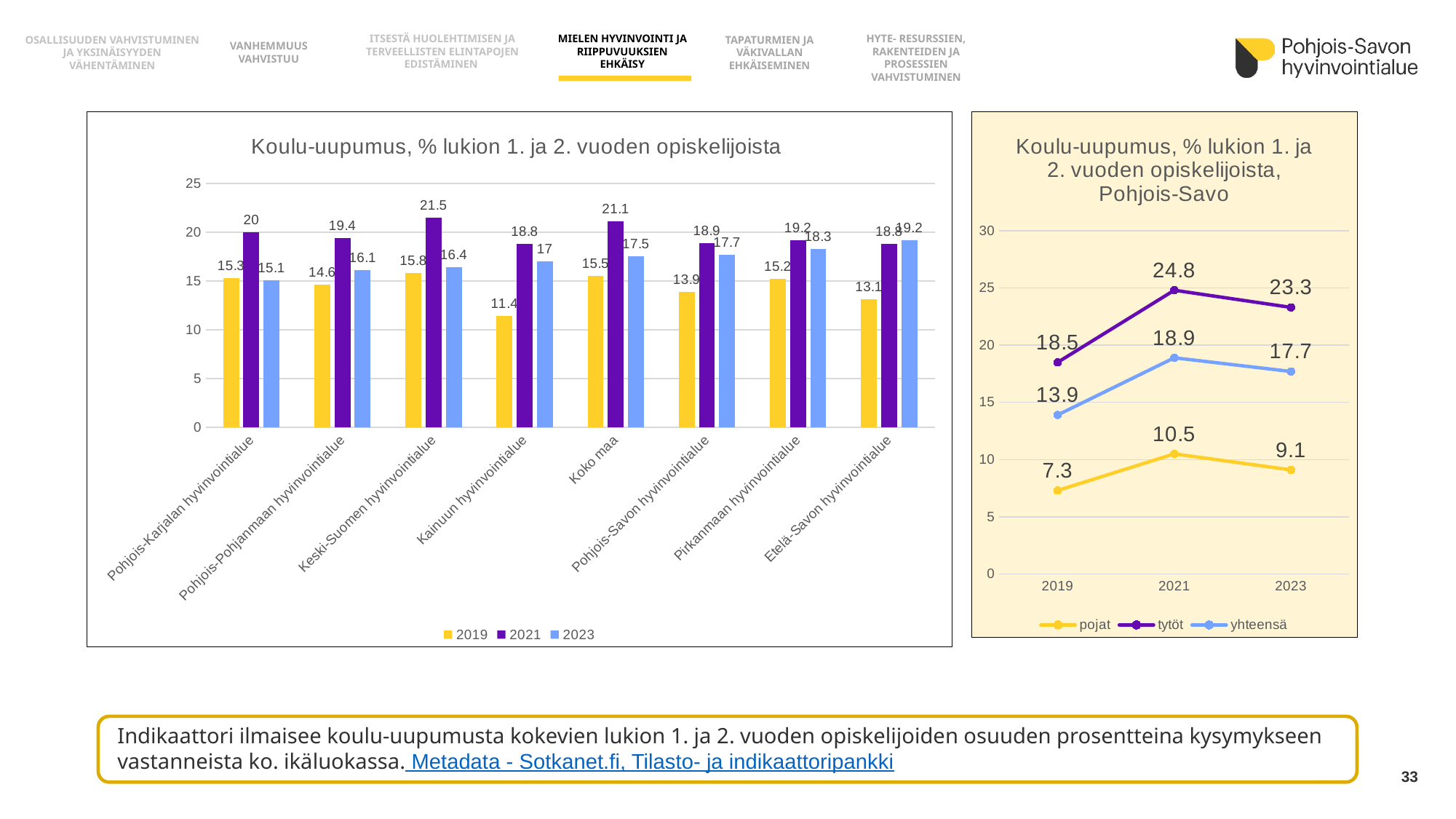
In the left chart, which category has the lowest 2019 value? Kainuun hyvinvointialue In the left chart, is the 2023 value for Pirkanmaan hyvinvointialue larger or smaller than the 2023 value for Pohjois-Savon hyvinvointialue? larger In the left chart 'Koulu-uupumus, % lukion 1. ja 2. vuoden opiskelijoista', what is the 2021 value for Keski-Suomen hyvinvointialue? 21.5 In the right chart (Pohjois-Savo), does the pojat series rise or fall from 2021 to 2023? fall In the left chart, which category has the highest 2021 value? Keski-Suomen hyvinvointialue In the left chart, what is the difference between the 2021 and 2023 values for Koko maa? 3.6 In the right chart (Pohjois-Savo), what is the difference between the tytöt and pojat values in 2023? 14.2 In the left chart, what is the 2019 value for Kainuun hyvinvointialue? 11.4 How many categories are shown on the x axis of the left bar chart? 8 How many series does the legend of the left chart list? 3 What kind of chart is the right chart titled 'Koulu-uupumus, % lukion 1. ja 2. vuoden opiskelijoista, Pohjois-Savo'? line chart In the right chart (Pohjois-Savo), what is the value for tytöt in 2021? 24.8